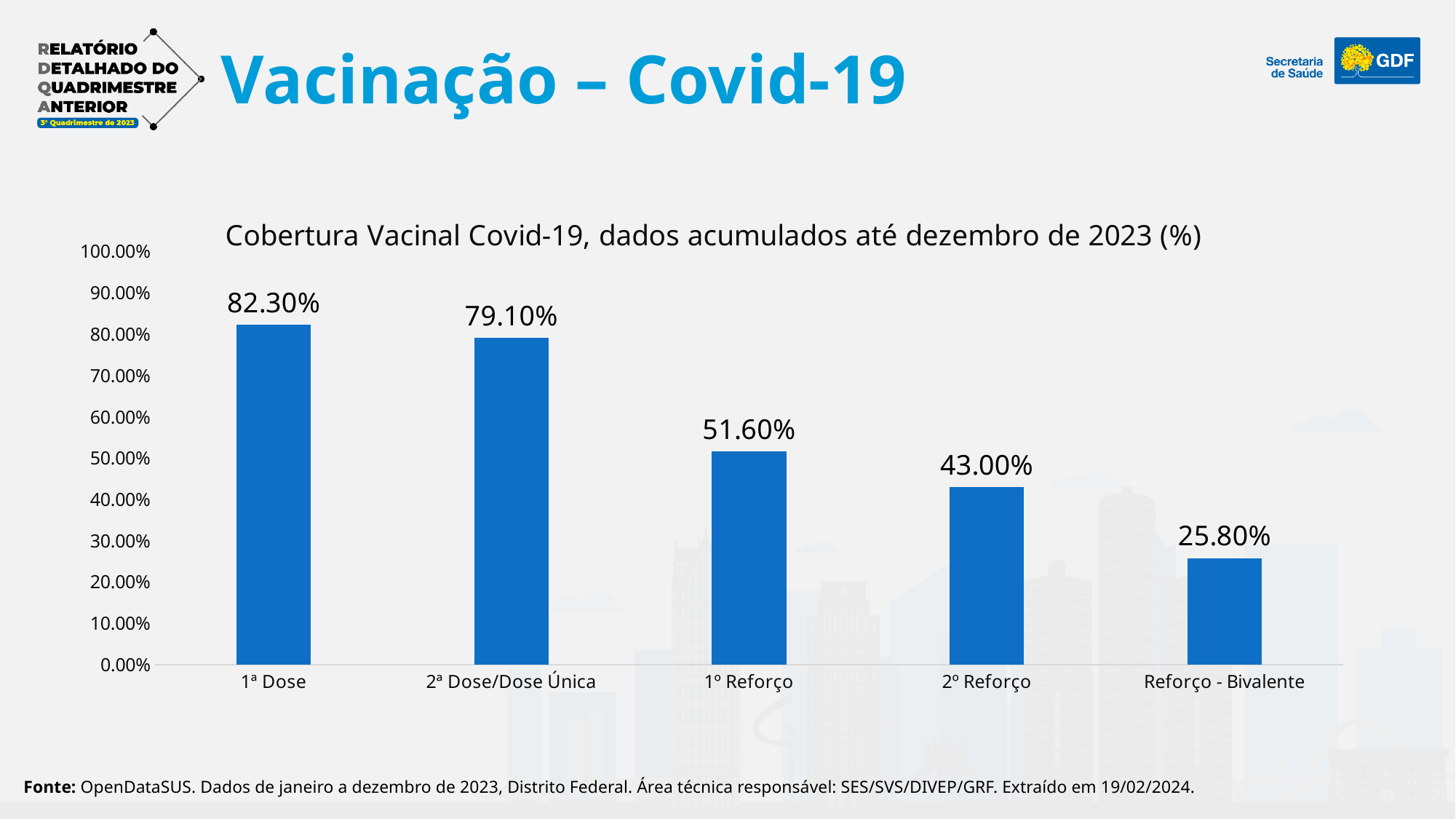
Which is larger, the value for 2º Reforço or the value for Reforço - Bivalente? 2º Reforço What is the title of the chart? Cobertura Vacinal Covid-19, dados acumulados até dezembro de 2023 (%) What is the difference between the values for 1º Reforço and 2º Reforço? 8.60% What is the value for 2ª Dose/Dose Única? 79.10% Which category has the highest value? 1ª Dose How many categories are shown on the chart? 5 Is the value for 1º Reforço greater or less than 50.00%? greater Do the values rise or fall from left to right along the x axis? fall What kind of chart is shown on the slide? bar chart Which category has the lowest value? Reforço - Bivalente What is the value for 1ª Dose? 82.30% What is the value for Reforço - Bivalente? 25.80%